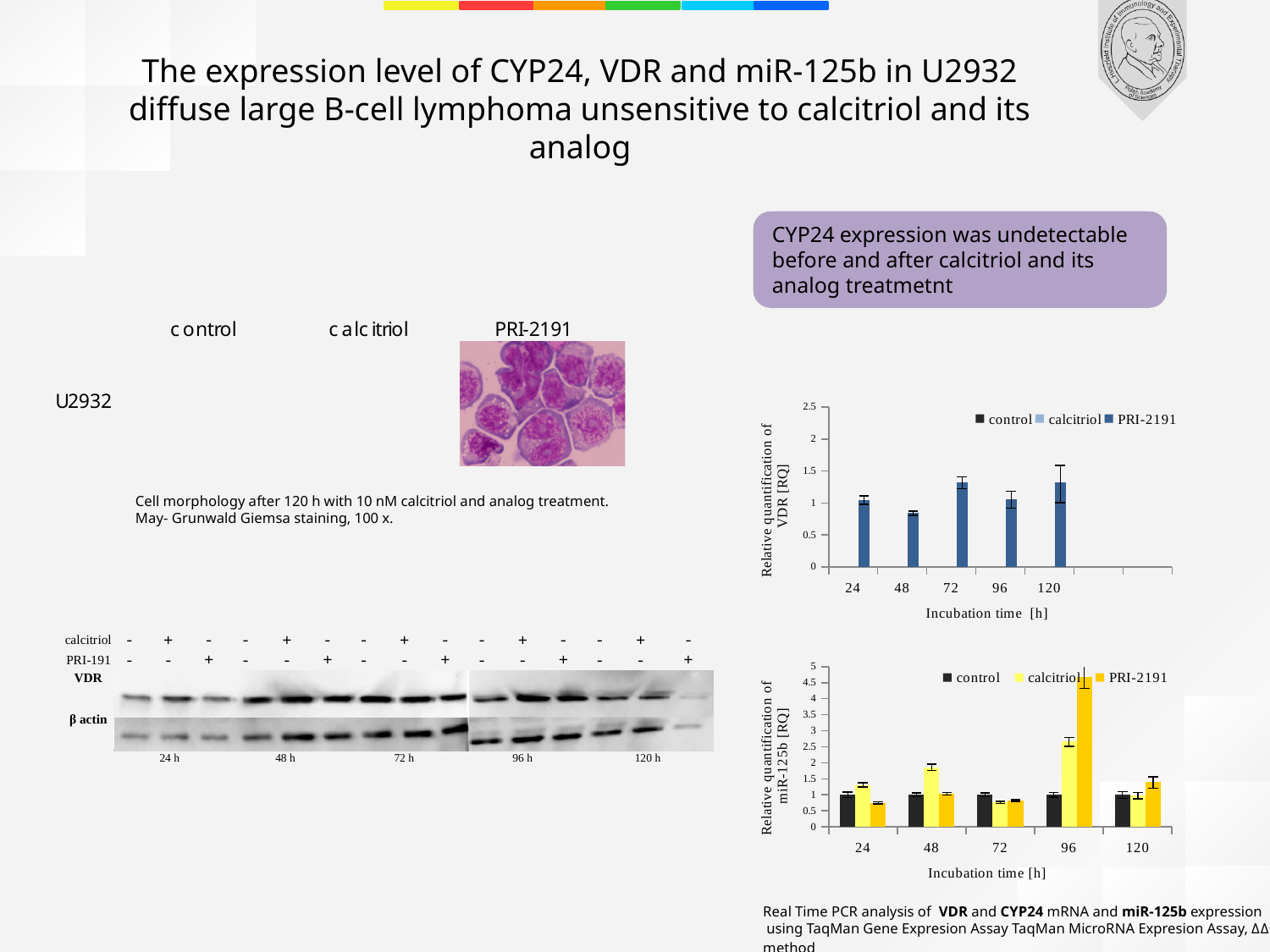
What kind of chart is the top chart (Relative quantification of VDR)? bar chart How many incubation time points are shown on the x axis of the bottom chart (Relative quantification of miR-125b)? 5 In the top chart (Relative quantification of VDR), at which incubation time is the bar lowest? 48 How many series does the legend of the bottom chart (Relative quantification of miR-125b) list? 3 In the bottom chart (Relative quantification of miR-125b), is the PRI-2191 value at 96 h greater or less than 4? greater In the bottom chart (Relative quantification of miR-125b), which series has the highest bar overall? PRI-2191 In the bottom chart (Relative quantification of miR-125b), at 48 h, which is larger: calcitriol or PRI-2191? calcitriol What is the x-axis title of the bottom chart (Relative quantification of miR-125b)? Incubation time [h] In the top chart (Relative quantification of VDR), is the value at 48 h greater or less than 1? less In the top chart (Relative quantification of VDR), is the value at 72 h greater or less than 1? greater In the bottom chart (Relative quantification of miR-125b), at 96 h, which is larger: calcitriol or PRI-2191? PRI-2191